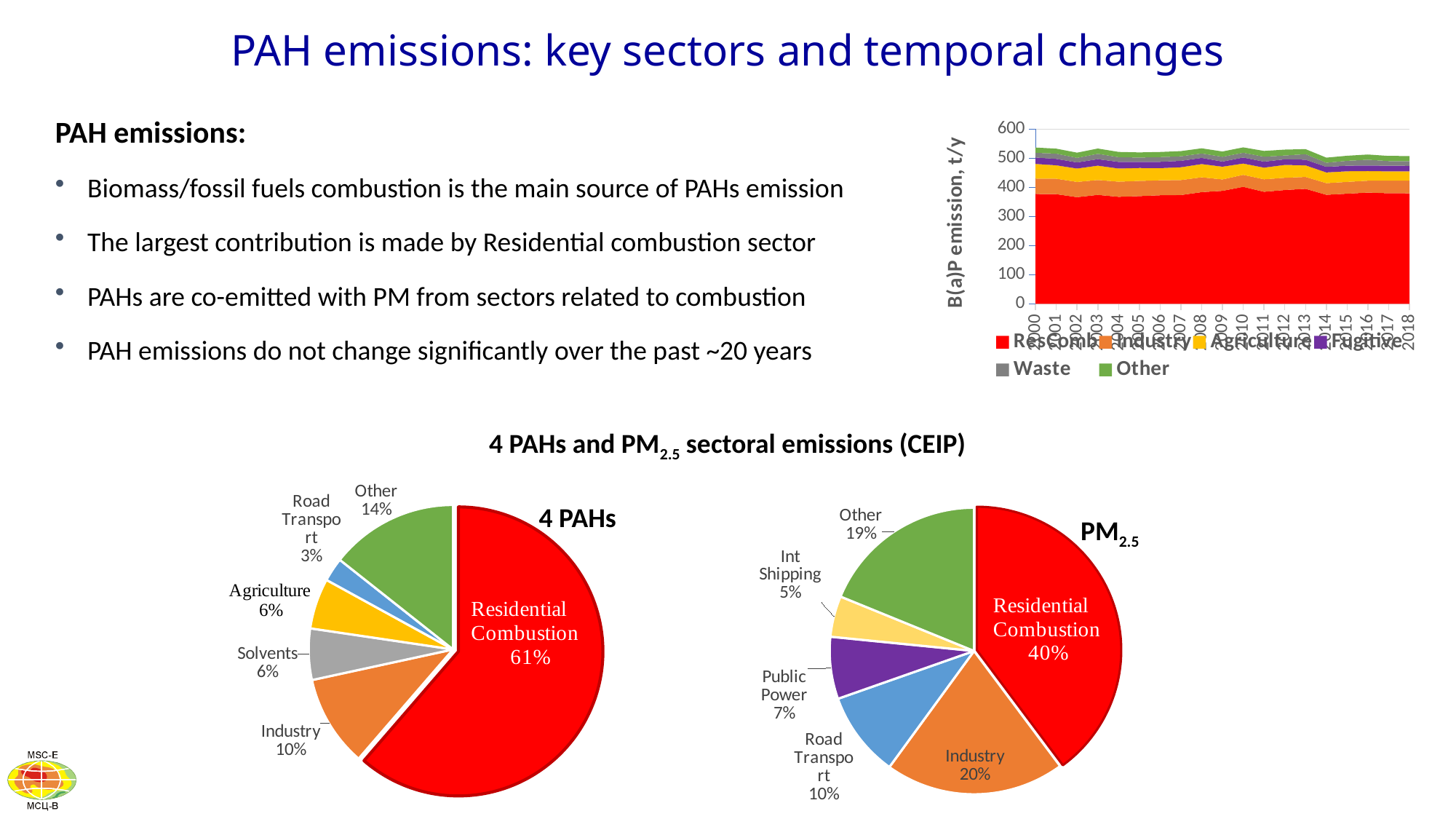
In the PM2.5 pie chart, what share does Int Shipping have? 5% How many series does the legend of the B(a)P emission chart in the top right list? 6 In the PM2.5 pie chart, which is larger: the share of Other or the share of Road Transport? Other How many slices does the 4 PAHs pie chart have? 6 In the PM2.5 pie chart, what share does Industry have? 20% What is the difference between the Residential Combustion share in the 4 PAHs pie chart and in the PM2.5 pie chart? 21 percentage points In the 4 PAHs pie chart, which sector has the smallest share? Road Transport What kind of chart is the B(a)P emission chart in the top right of the slide? Stacked area chart In the 4 PAHs pie chart, what is the combined share of Solvents and Agriculture? 12% In the 4 PAHs pie chart, what share does Residential Combustion have? 61% In the PM2.5 pie chart, which sector has the largest share? Residential Combustion In the B(a)P emission chart in the top right, is the total emission in 2018 greater or less than 600 t/y? less